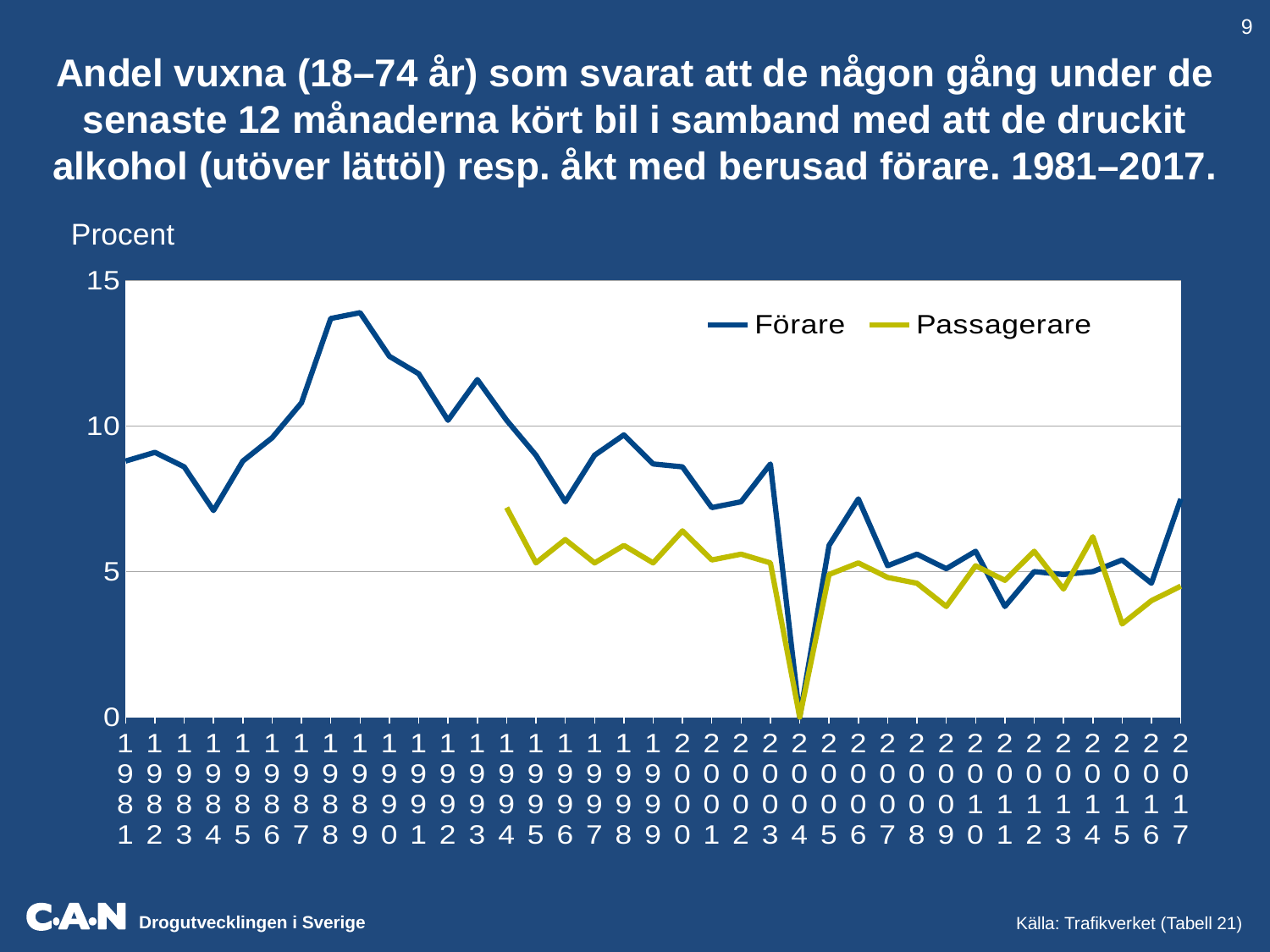
How many series does the legend list? 2 What unit label is shown above the y axis? Procent How many years are shown on the x axis? 37 Is the value for Förare in 1981 greater or less than 10? less Is the value for Förare in 1989 greater or less than 10? greater Is the value for Passagerare in 1994 greater or less than 5? greater In 2017, which series has the higher value, Förare or Passagerare? Förare Does the Förare line rise or fall between 1984 and 1989? rise What are the two series named in the legend? Förare and Passagerare What kind of chart is shown on the slide? line chart